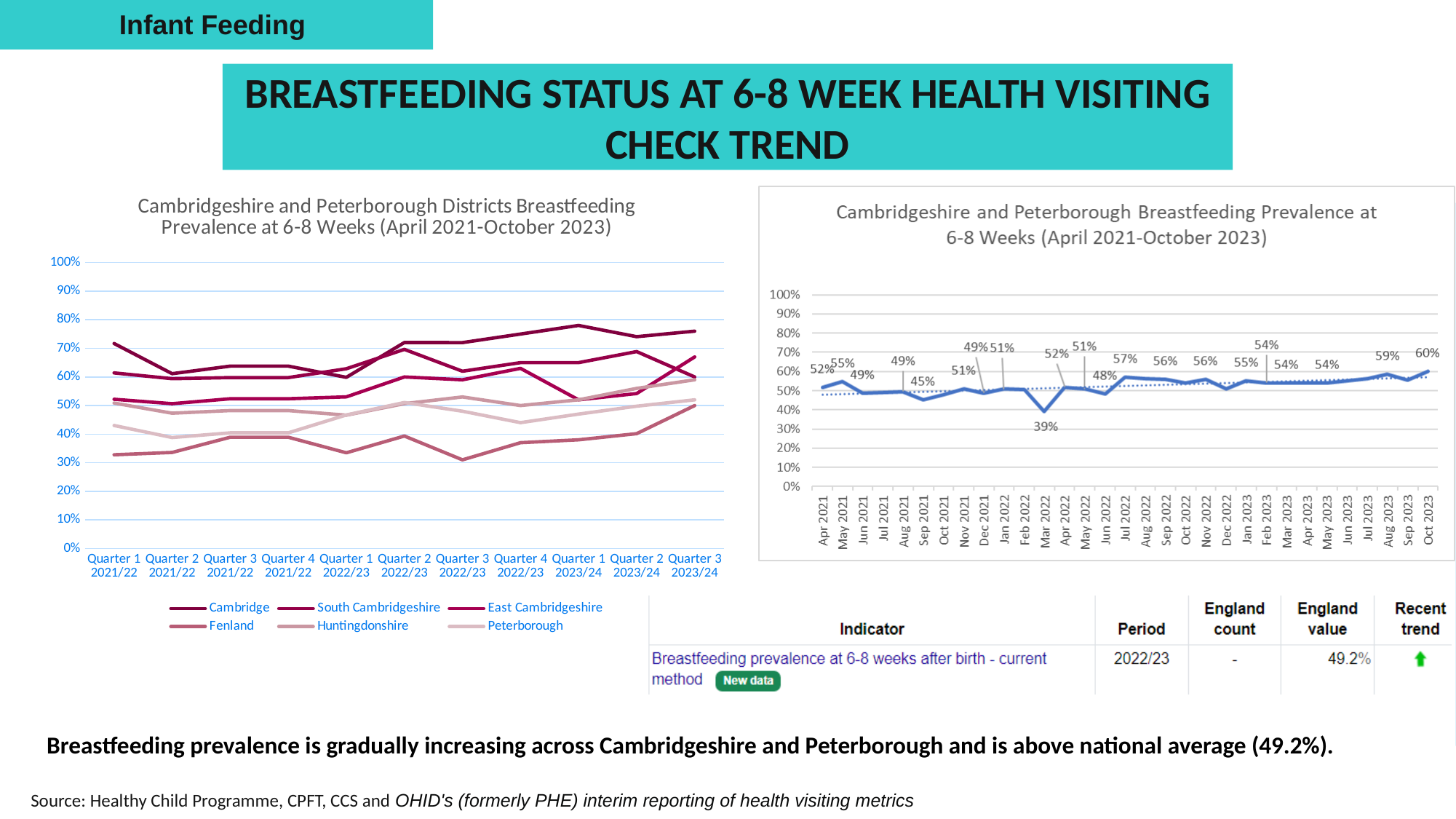
In the right-hand chart (Cambridgeshire and Peterborough Breastfeeding Prevalence), how many percentage points higher is Oct 2023 than Apr 2021? 8 percentage points In the left-hand chart (Cambridgeshire and Peterborough Districts Breastfeeding Prevalence), is the value for Fenland in Quarter 1 2021/22 greater or less than 40%? less How many quarters are shown on the x axis of the left-hand chart (Cambridgeshire and Peterborough Districts Breastfeeding Prevalence)? 11 How many series does the legend of the left-hand chart (Cambridgeshire and Peterborough Districts Breastfeeding Prevalence) list? 6 In the right-hand chart (Cambridgeshire and Peterborough Breastfeeding Prevalence), do the values generally rise or fall from Apr 2021 to Oct 2023? Rise In the right-hand chart (Cambridgeshire and Peterborough Breastfeeding Prevalence), which month has the lowest value? Mar 2022 In the right-hand chart (Cambridgeshire and Peterborough Breastfeeding Prevalence), what is the value for Oct 2023? 60% In the right-hand chart (Cambridgeshire and Peterborough Breastfeeding Prevalence), what is the highest value shown? 60% In the left-hand chart (Cambridgeshire and Peterborough Districts Breastfeeding Prevalence), which district has the highest value in Quarter 3 2023/24? Cambridge What kind of chart is the right-hand chart, 'Cambridgeshire and Peterborough Breastfeeding Prevalence at 6-8 Weeks'? Line chart In the right-hand chart (Cambridgeshire and Peterborough Breastfeeding Prevalence), what is the lowest value shown? 39% In the right-hand chart (Cambridgeshire and Peterborough Breastfeeding Prevalence), what is the value for Apr 2021? 52%